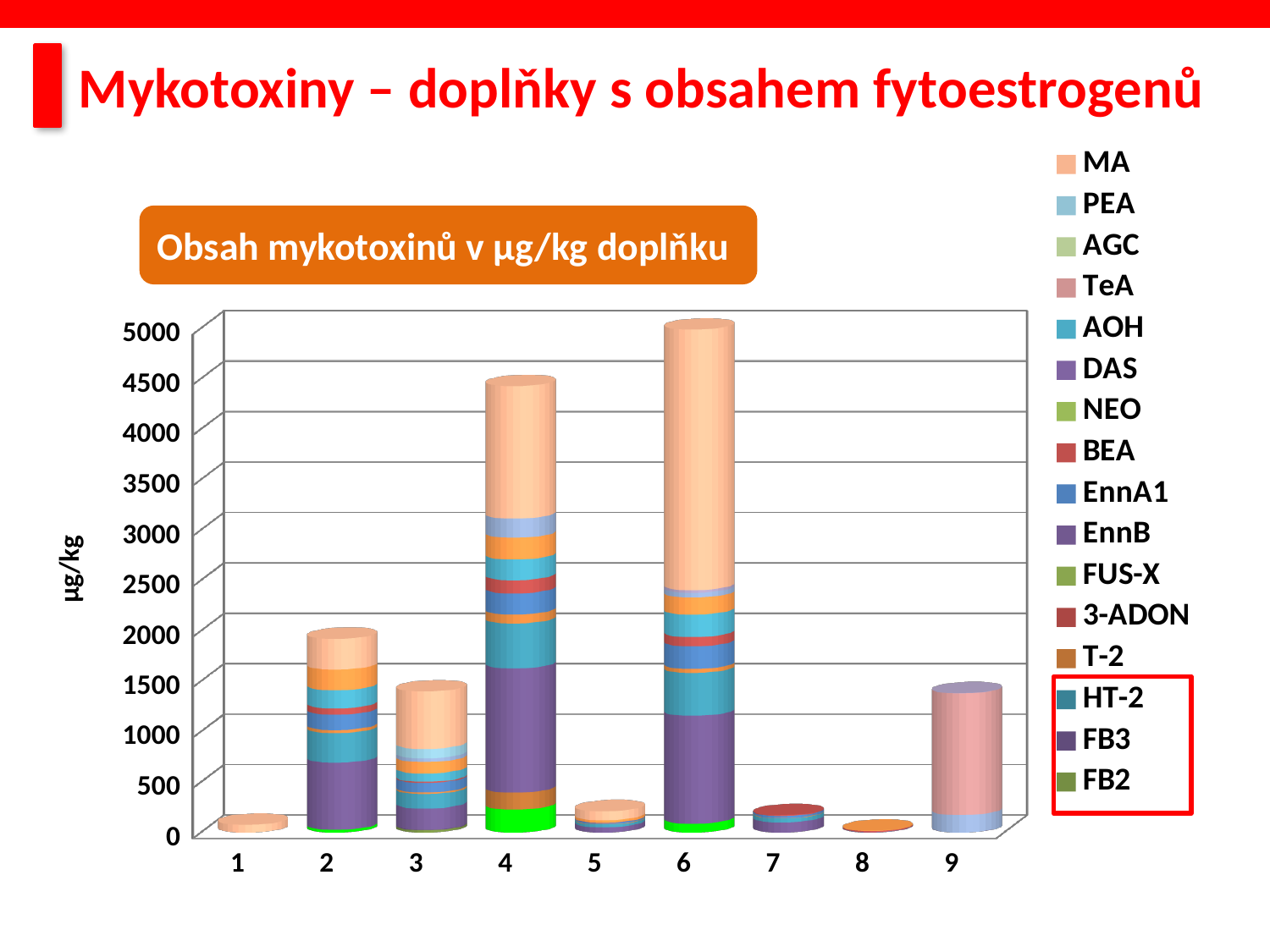
How many series does the legend list? 16 Is the total value for sample 6 greater or less than 4500? greater Which three legend entries are outlined with a red box? HT-2, FB3, FB2 What is the label on the y axis? µg/kg Is the total value for sample 1 greater or less than 500? less Which sample has the highest total mycotoxin content? 6 What kind of chart is shown on the slide? Stacked bar chart How many categories (samples) are shown on the x axis? 9 Which sample has a larger total, sample 2 or sample 3? 2 Which sample has the lowest total mycotoxin content? 8 Is the total value for sample 9 greater or less than 1000? greater